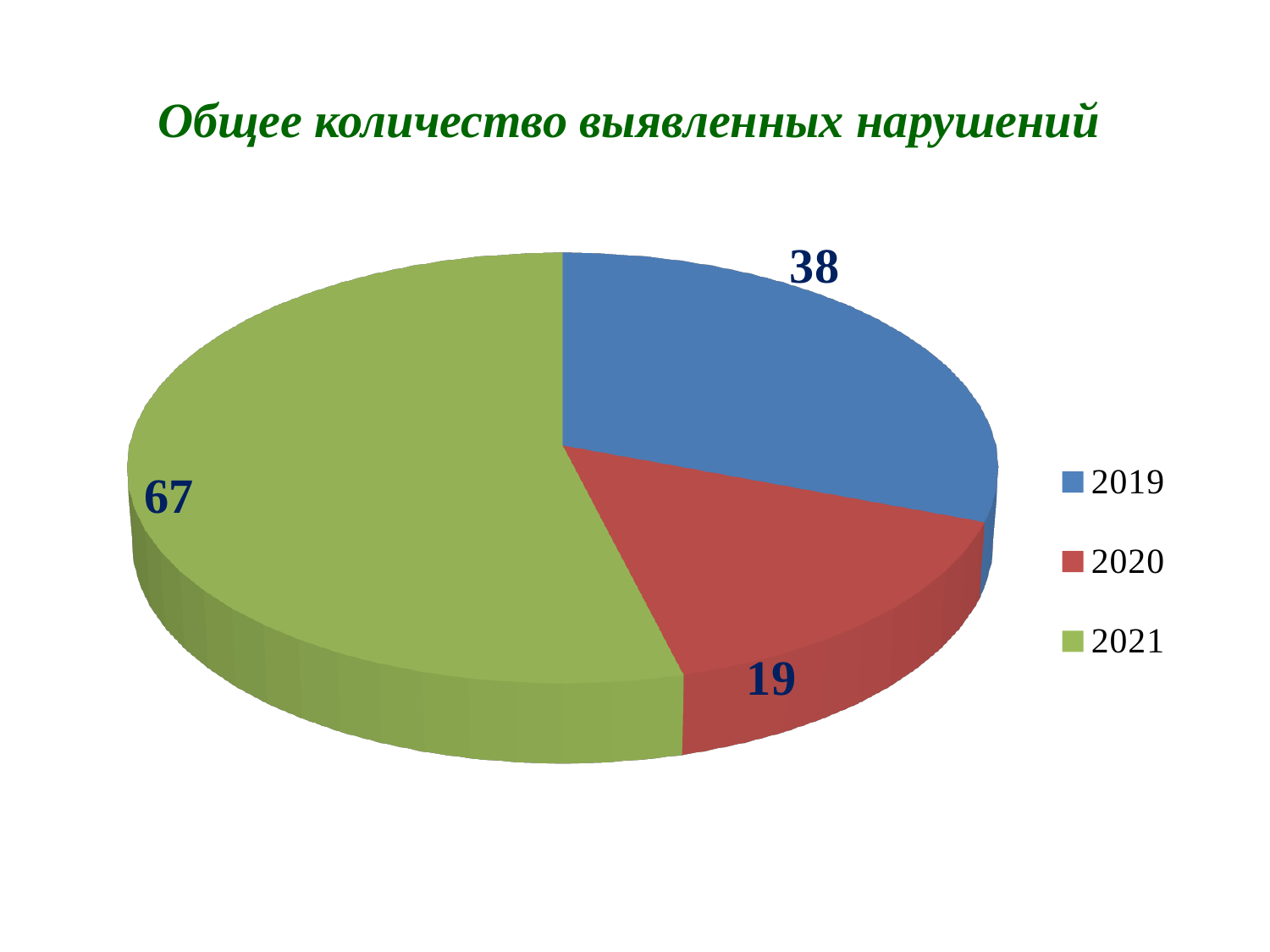
Which year has the largest slice? 2021 What is the value for 2021? 67 What is the difference between the values for 2021 and 2019? 29 What kind of chart is shown on the slide? Pie chart What is the title of the chart? Общее количество выявленных нарушений Which year has the smallest slice? 2020 What is the difference between the values for 2019 and 2020? 19 What is the total of all slices in the pie chart? 124 What is the value for 2020? 19 Which is larger, the value for 2019 or the value for 2020? 2019 How many slices does the pie chart have? 3 What is the value for 2019? 38